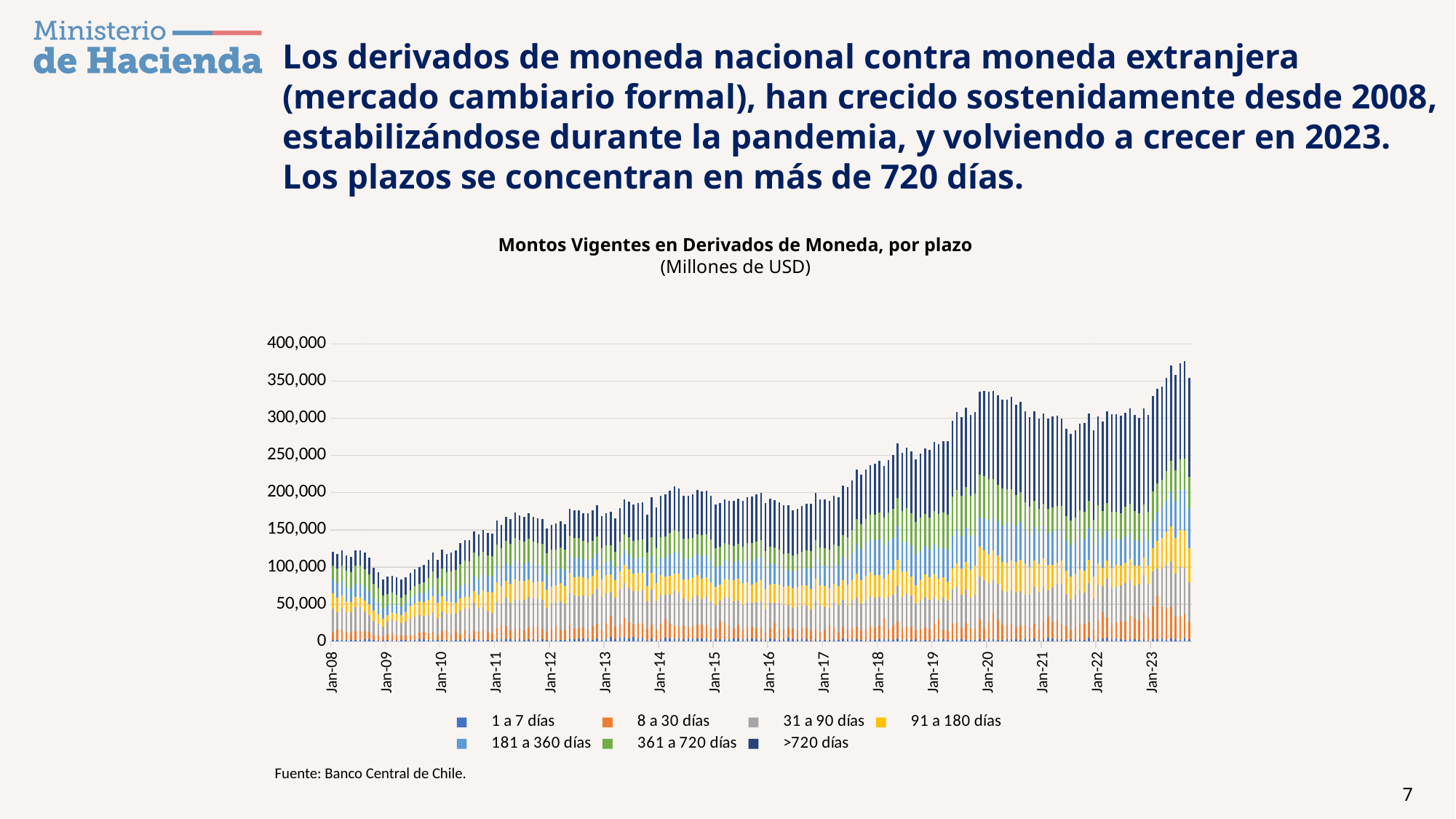
Overall, do the total stacked values rise or fall from Jan-08 to 2023? rise What kind of chart is shown on the slide? Stacked bar chart Which has a larger total stacked value, Jan-09 or Jan-20? Jan-20 Is the total stacked value for Jan-09 greater or less than 100,000? less In what unit are the values of the chart expressed? Millones de USD Is the total stacked value for Jan-20 greater or less than 300,000? greater How many year labels (Jan-08 to Jan-23) are shown on the x axis? 16 How many series does the legend list? 7 What is the title of the chart? Montos Vigentes en Derivados de Moneda, por plazo Which has a larger total stacked value, Jan-08 or Jan-23? Jan-23 Is the total stacked value for Jan-19 greater or less than 250,000? greater